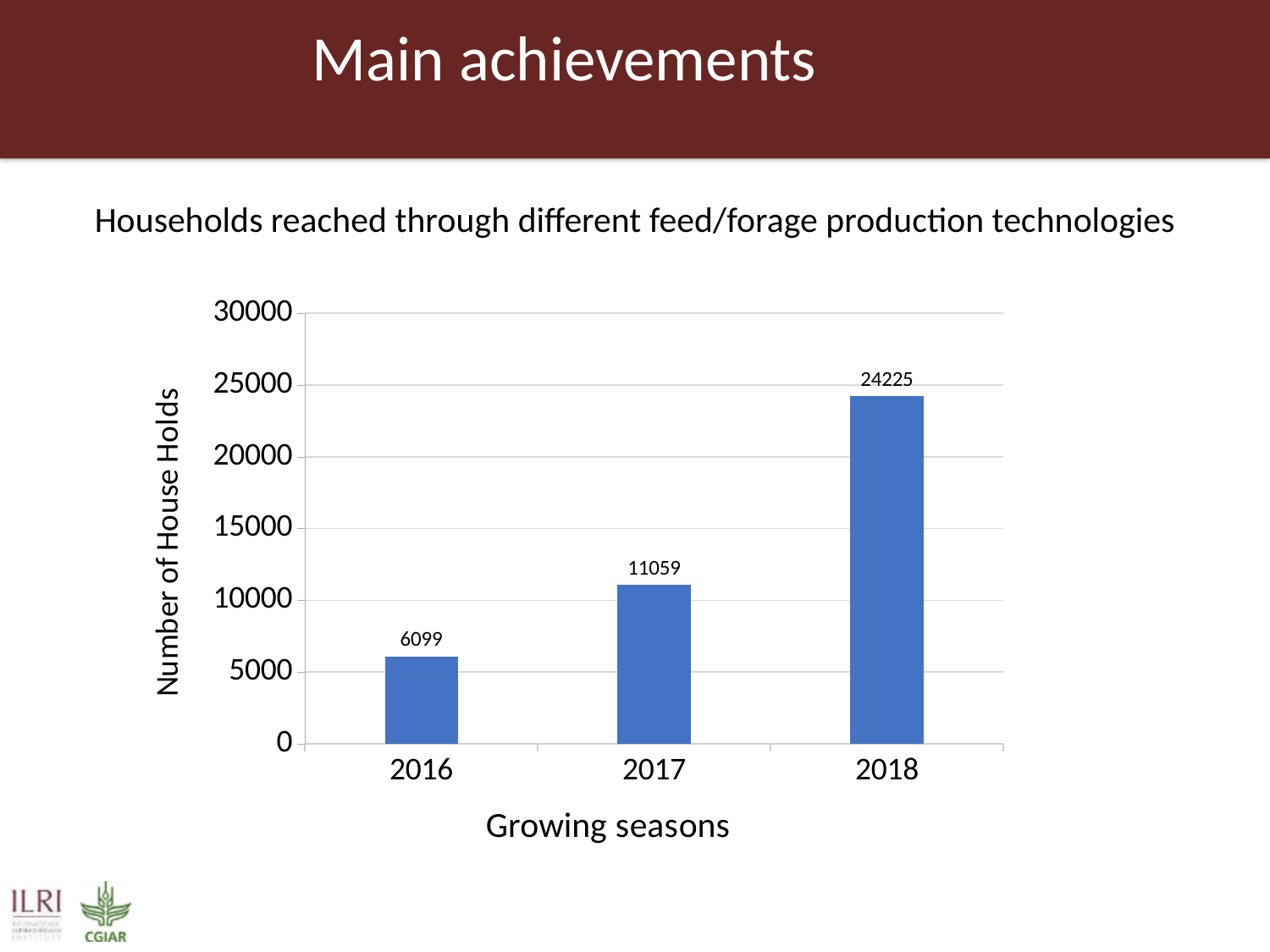
What type of chart is shown on the slide? Bar chart How many growing seasons are shown on the chart? 3 How many more households were reached in 2017 than in 2016? 4960 What is the value shown for the 2018 growing season? 24225 Which growing season has the highest number of households reached? 2018 How many households were reached in 2016? 6099 Which growing season has the lowest number of households reached? 2016 Which year had more households reached, 2016 or 2017? 2017 Is the value for 2018 greater or less than 20000? greater What is the difference between the number of households reached in 2018 and in 2017? 13166 Do the values rise or fall from 2016 to 2018? Rise What is the number of households reached in 2017? 11059